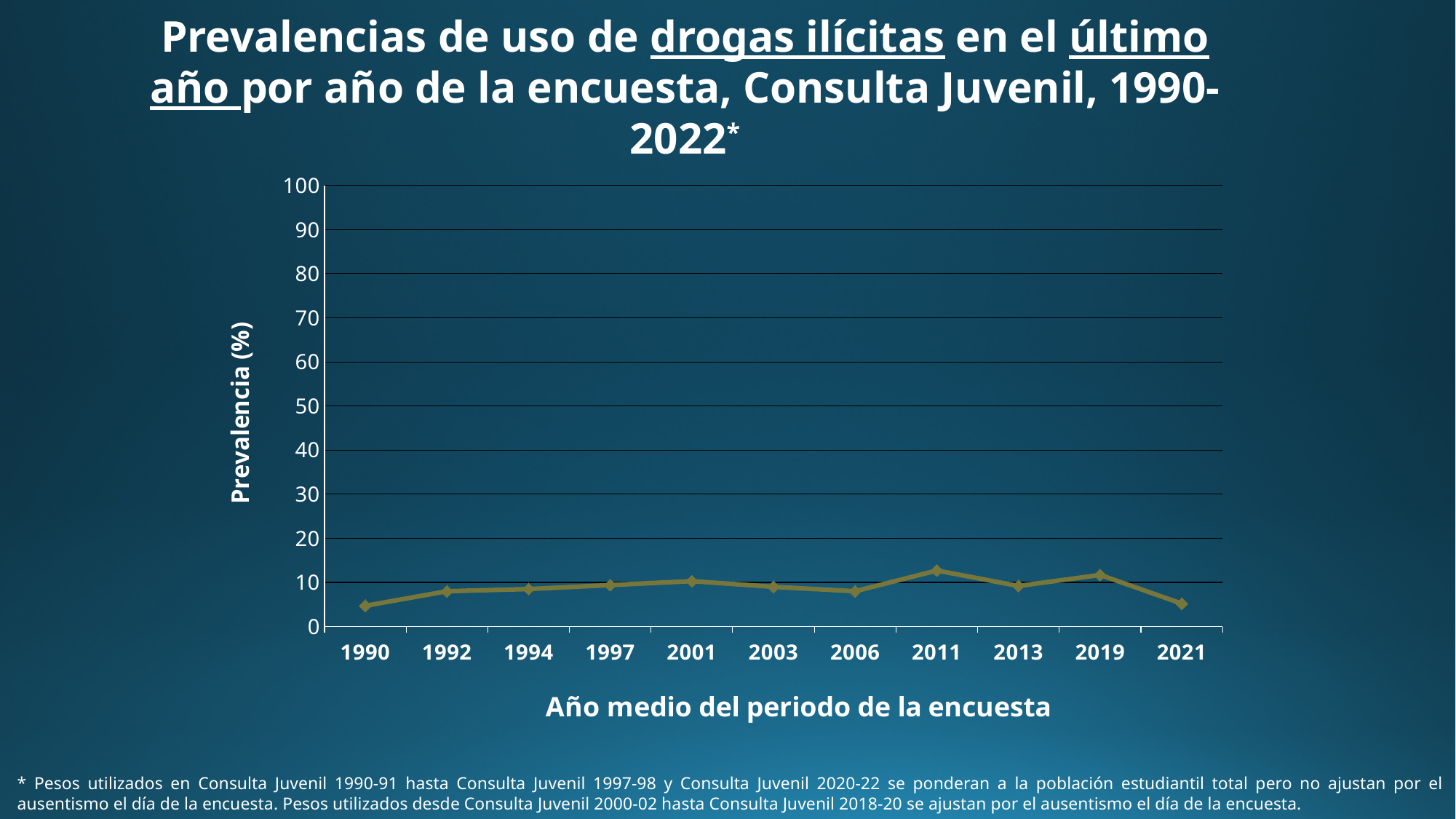
How many survey years are plotted on the x axis? 11 What is the label of the x axis? Año medio del periodo de la encuesta Is the value for 1990 greater or less than 10? less Which survey year has the highest prevalence? 2011 Which is larger, the value for 2011 or the value for 2006? 2011 Is the value for 2011 greater or less than 10? greater What kind of chart is shown on the slide? line chart Is the value for 2021 greater or less than 10? less What is the label of the y axis? Prevalencia (%) Does the prevalence rise or fall from 2019 to 2021? fall Which is larger, the value for 1990 or the value for 2019? 2019